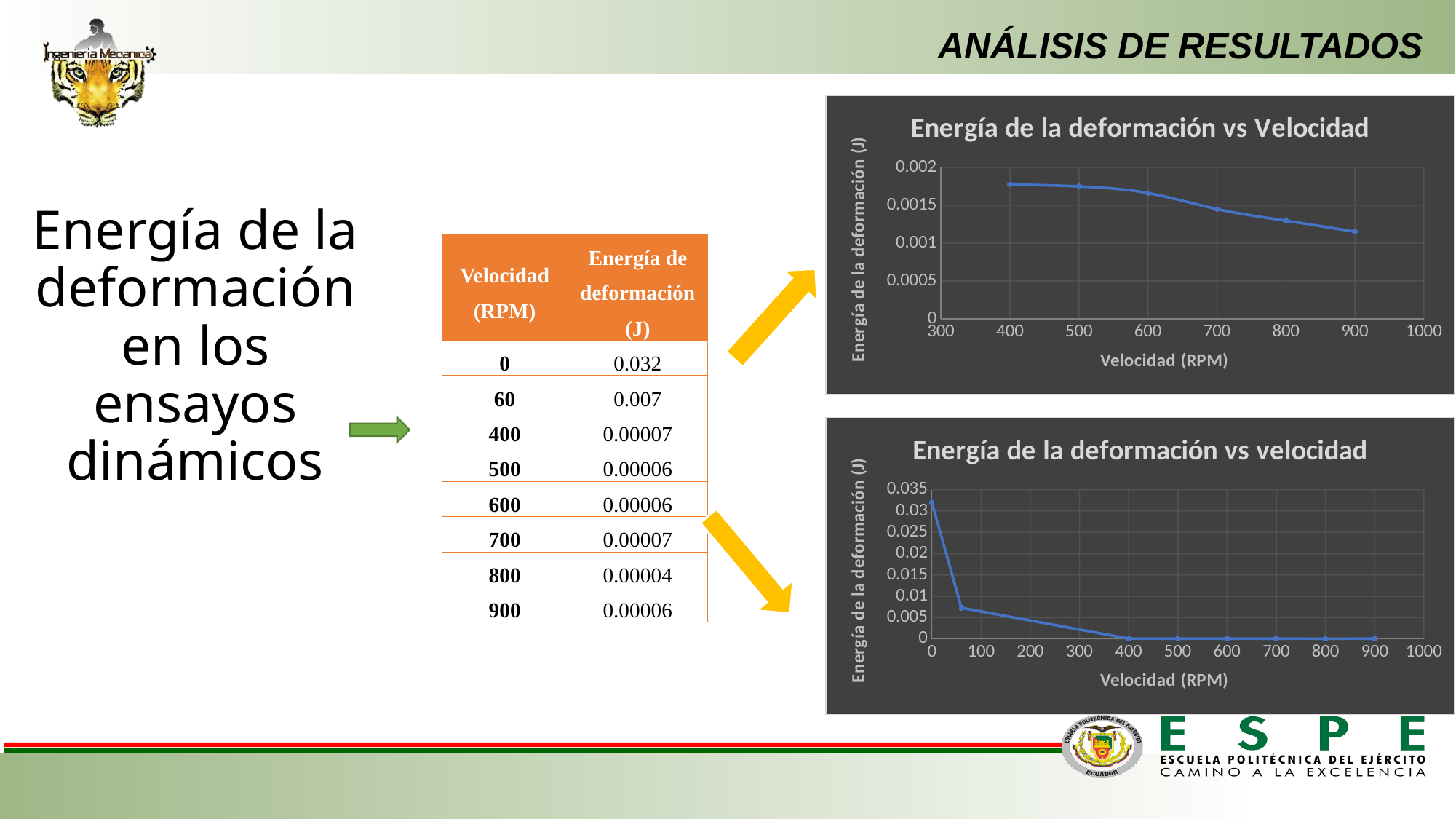
In the top chart 'Energía de la deformación vs Velocidad', do the values rise or fall as velocity increases from 400 to 900 RPM? fall In the top chart 'Energía de la deformación vs Velocidad', which is larger: the value at 600 RPM or the value at 800 RPM? 600 RPM In the top chart 'Energía de la deformación vs Velocidad', at which velocity is the deformation energy lowest? 900 RPM In the top chart 'Energía de la deformación vs Velocidad', how many data points are plotted? 6 In the bottom chart 'Energía de la deformación vs velocidad', is the value at 0 RPM greater or less than 0.03? greater In the bottom chart 'Energía de la deformación vs velocidad', at which velocity is the deformation energy highest? 0 RPM What is the x-axis title of the bottom chart 'Energía de la deformación vs velocidad'? Velocidad (RPM) In the bottom chart 'Energía de la deformación vs velocidad', is the value at 60 RPM greater or less than 0.01? less In the bottom chart 'Energía de la deformación vs velocidad', how many data points are plotted? 8 What kind of chart is the top chart titled 'Energía de la deformación vs Velocidad'? line chart In the top chart 'Energía de la deformación vs Velocidad', is the value at 400 RPM greater or less than 0.0015? greater